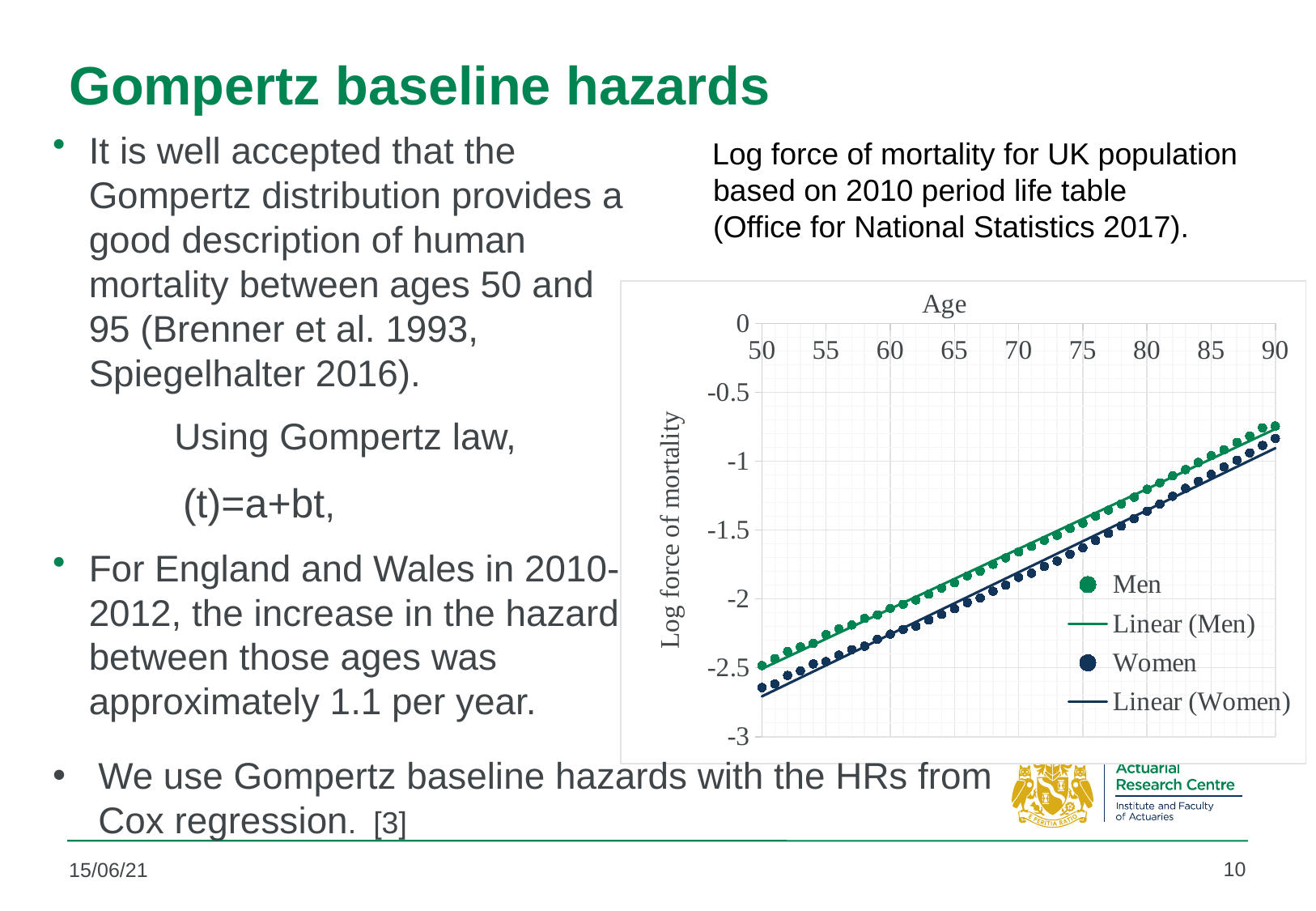
Do the log force of mortality values for Women rise or fall as age increases? rise Is the value for Men at age 70 greater or less than -2? greater Is the value for Women at age 70 greater or less than -1.5? less How many entries does the chart legend list? 4 What is the title of the horizontal axis of the chart? Age Is the value for Women at age 50 greater or less than -2.5? less At age 50, which series has the higher log force of mortality, Men or Women? Men At age 90, which series has the higher log force of mortality, Men or Women? Men Do the log force of mortality values for Men rise or fall as age increases? rise What kind of chart is shown on the slide? scatter chart What is the title of the vertical axis of the chart? Log force of mortality